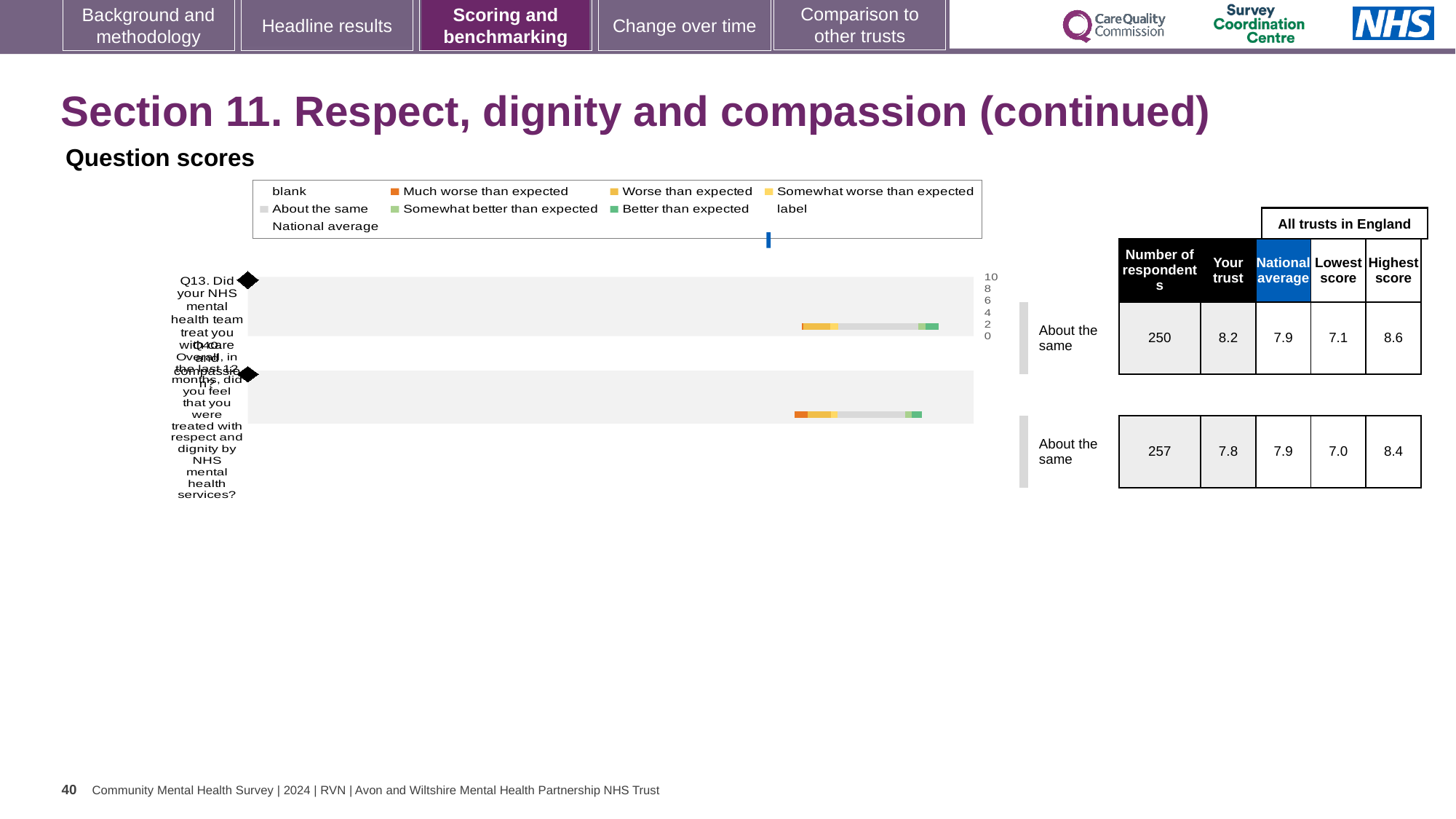
Which question has the higher 'Your trust' score, Q13 or Q14? Q13 What is the number of respondents for Q14? 257 What kind of chart is used to show the question scores on this slide? bar chart What is the highest score among all trusts in England for Q13? 8.6 What is the difference between the highest and lowest scores for Q14 across all trusts in England? 1.4 What is the lowest score among all trusts in England for Q14? 7.0 What benchmark category label is shown next to both Q13 and Q14 in the chart? About the same What is the national average score for Q13? 7.9 What is the 'Your trust' score for Q14 (treated with respect and dignity)? 7.8 What is the difference between the 'Your trust' score and the national average for Q13? 0.3 How many questions (categories) are plotted in the question scores chart? 2 What is the 'Your trust' score for Q13 (treated with care and compassion)? 8.2